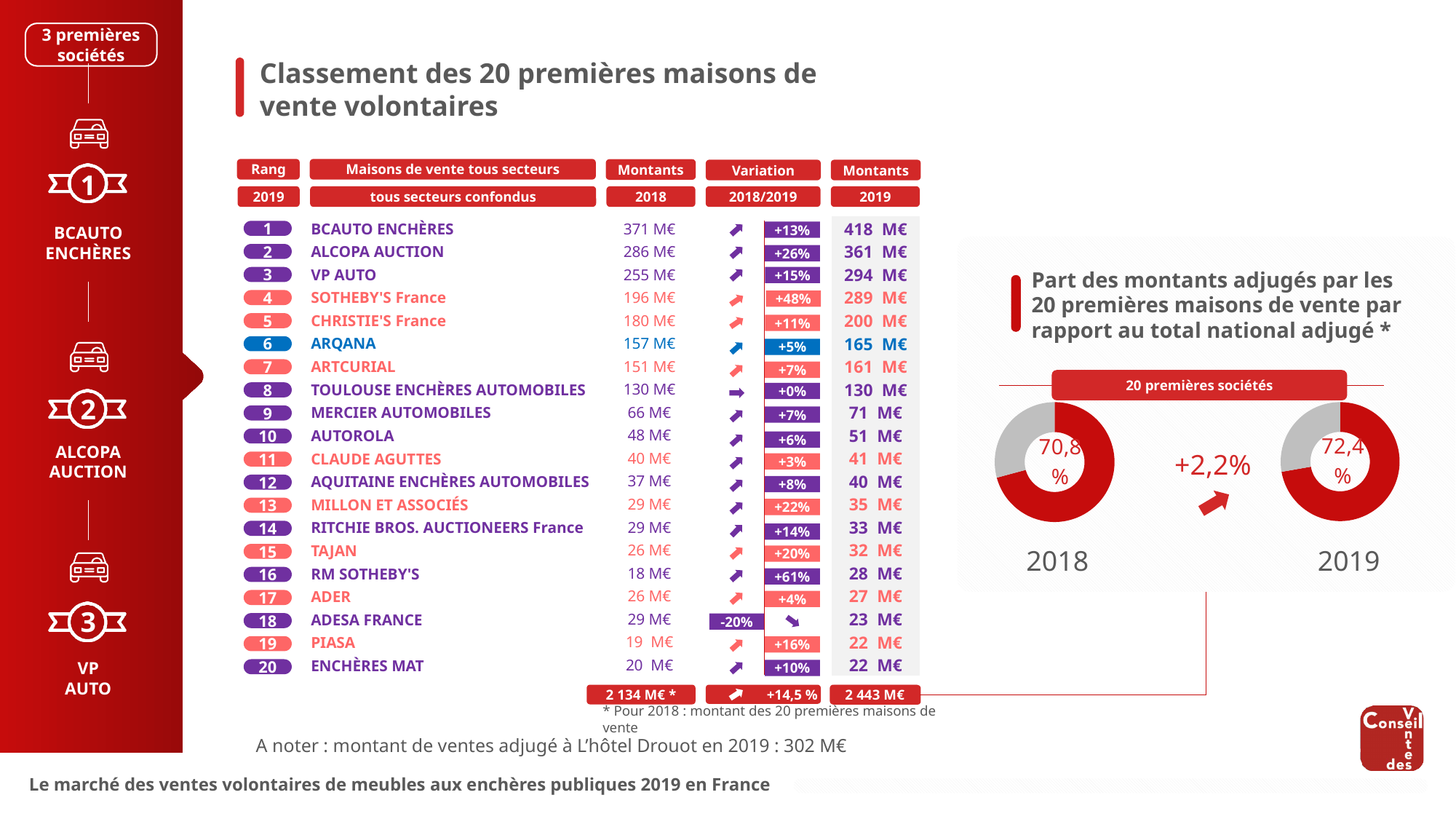
What is the title above the two donut charts? Part des montants adjugés par les 20 premières maisons de vente par rapport au total national adjugé * How many donut charts are shown on the right side of the slide? 2 In the 2019 donut chart, is the share of the 20 premières sociétés greater or less than 50%? greater Did the share of the 20 premières sociétés rise or fall from the 2018 donut chart to the 2019 donut chart? Rise What label appears in the red banner above the two donut charts? 20 premières sociétés Which year's donut chart shows the larger share for the 20 premières sociétés, 2018 or 2019? 2019 In the 2018 donut chart, what share of the total national amount is attributed to the 20 premières sociétés? 70,8% By how many percentage points did the share of the 20 premières sociétés change between the 2018 and 2019 donut charts? +2,2% What type of chart is used to show the share of the 20 premières sociétés for 2018 and 2019? Donut (pie) chart In the 2019 donut chart, what share of the total national amount is attributed to the 20 premières sociétés? 72,4% In the 2018 donut chart, is the share of the 20 premières sociétés greater or less than 75%? less